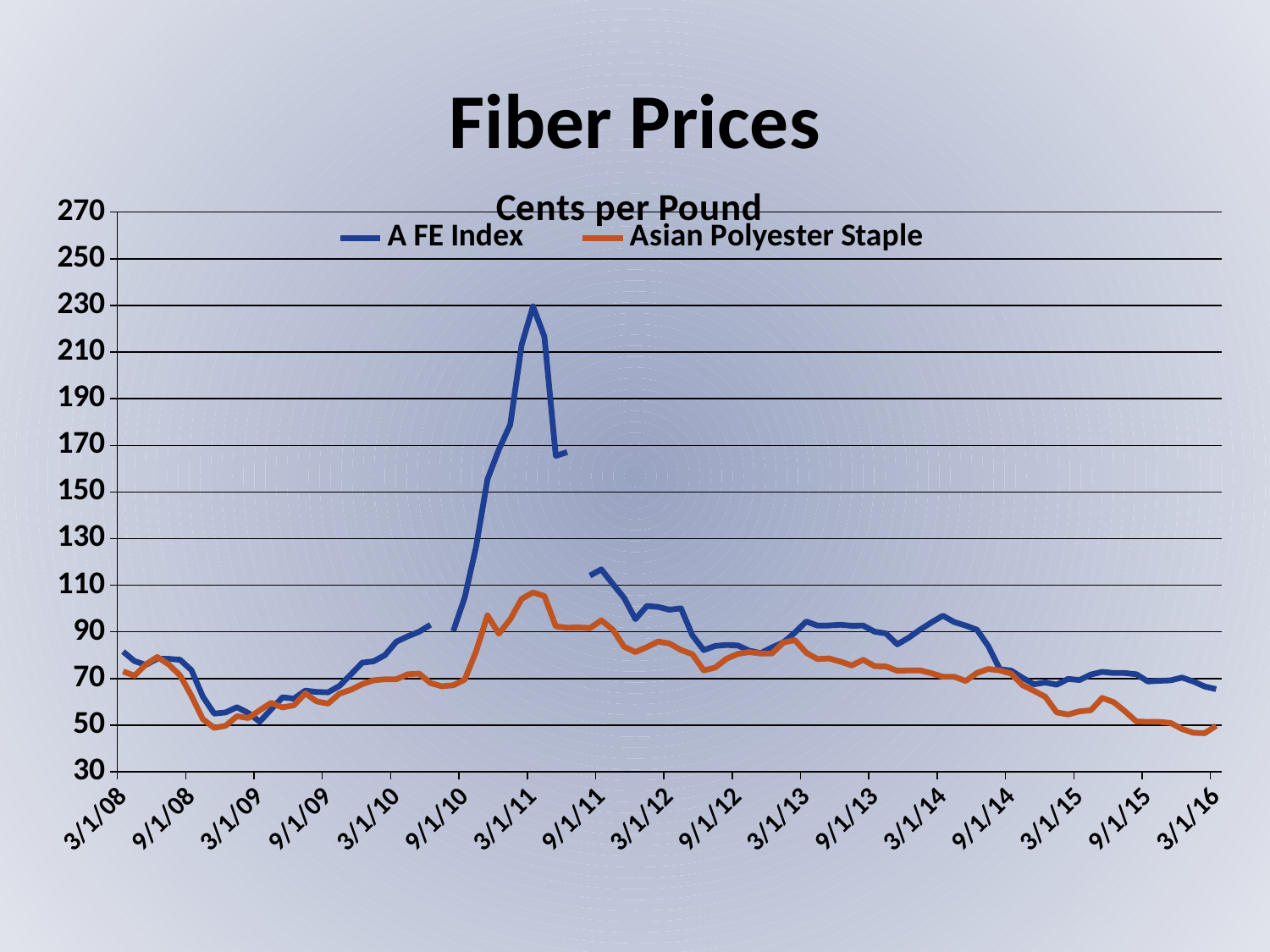
Is the value of Asian Polyester Staple at 3/1/16 greater or less than 70? less Is the value of Asian Polyester Staple at 3/1/11 greater or less than 90? greater What kind of chart is shown on the slide? line chart At 3/1/16, which series has the higher value, A FE Index or Asian Polyester Staple? A FE Index What is the title of the chart? Cents per Pound Around which x-axis date does the A FE Index reach its peak? 3/1/11 Does the Asian Polyester Staple series rise or fall between 3/1/13 and 3/1/16? fall How many series does the legend list? 2 Is the peak value of the A FE Index greater or less than 190? greater Which series reaches the highest value on the chart? A FE Index Which series is drawn in orange? Asian Polyester Staple